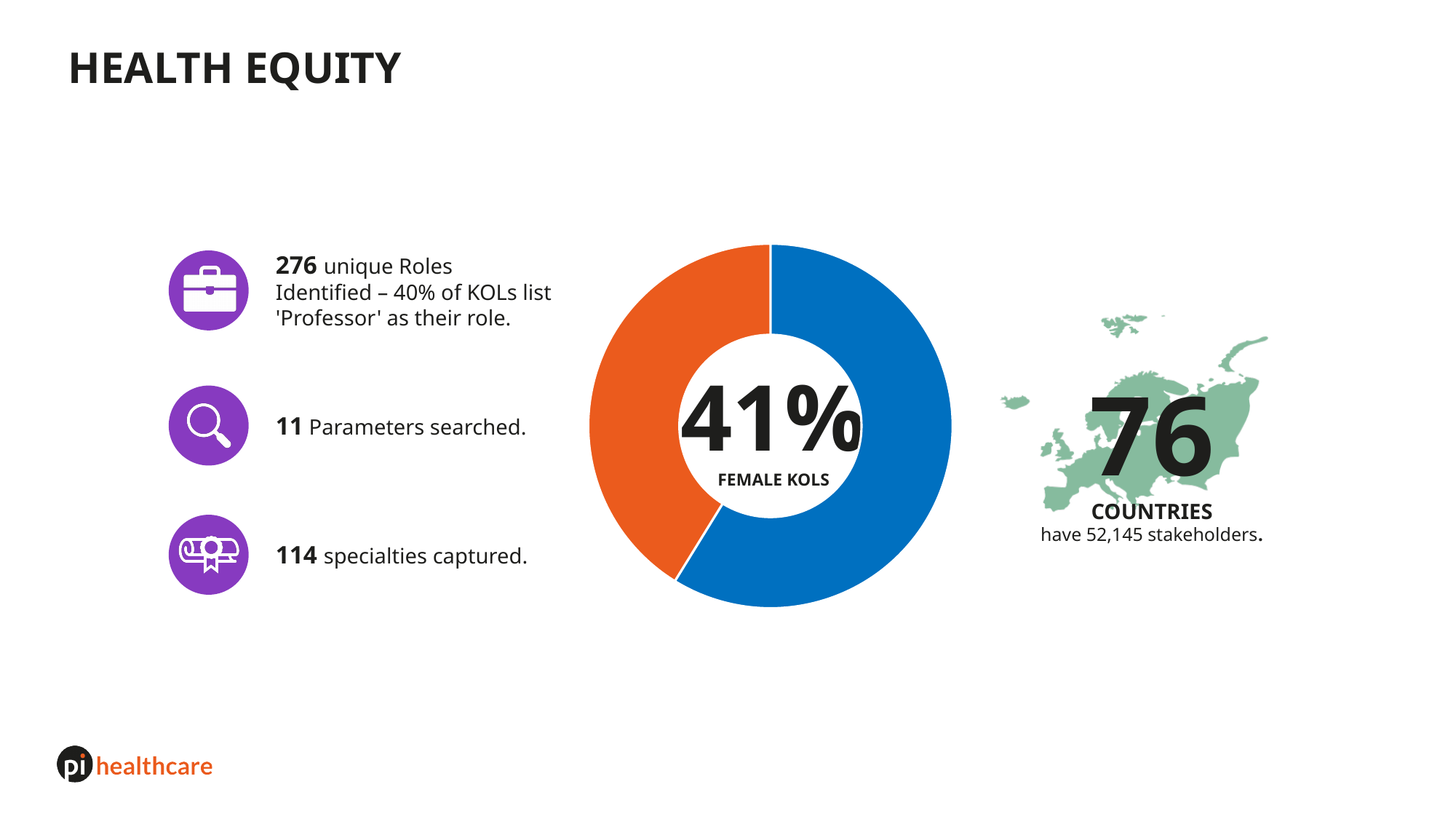
How many slices does the donut chart have? 2 Which colour slice of the donut chart is larger, the blue or the orange? Blue What kind of chart is shown in the centre of the slide? Donut (pie) chart What share of the donut chart is not female KOLs? 59% Is the share of female KOLs shown in the donut chart greater or less than 50%? less What label appears beneath the percentage in the centre of the donut chart? FEMALE KOLS What two colours are used for the slices of the donut chart? Orange and blue What percentage of KOLs are female according to the donut chart? 41% Which colour slice of the donut chart is the smallest? Orange